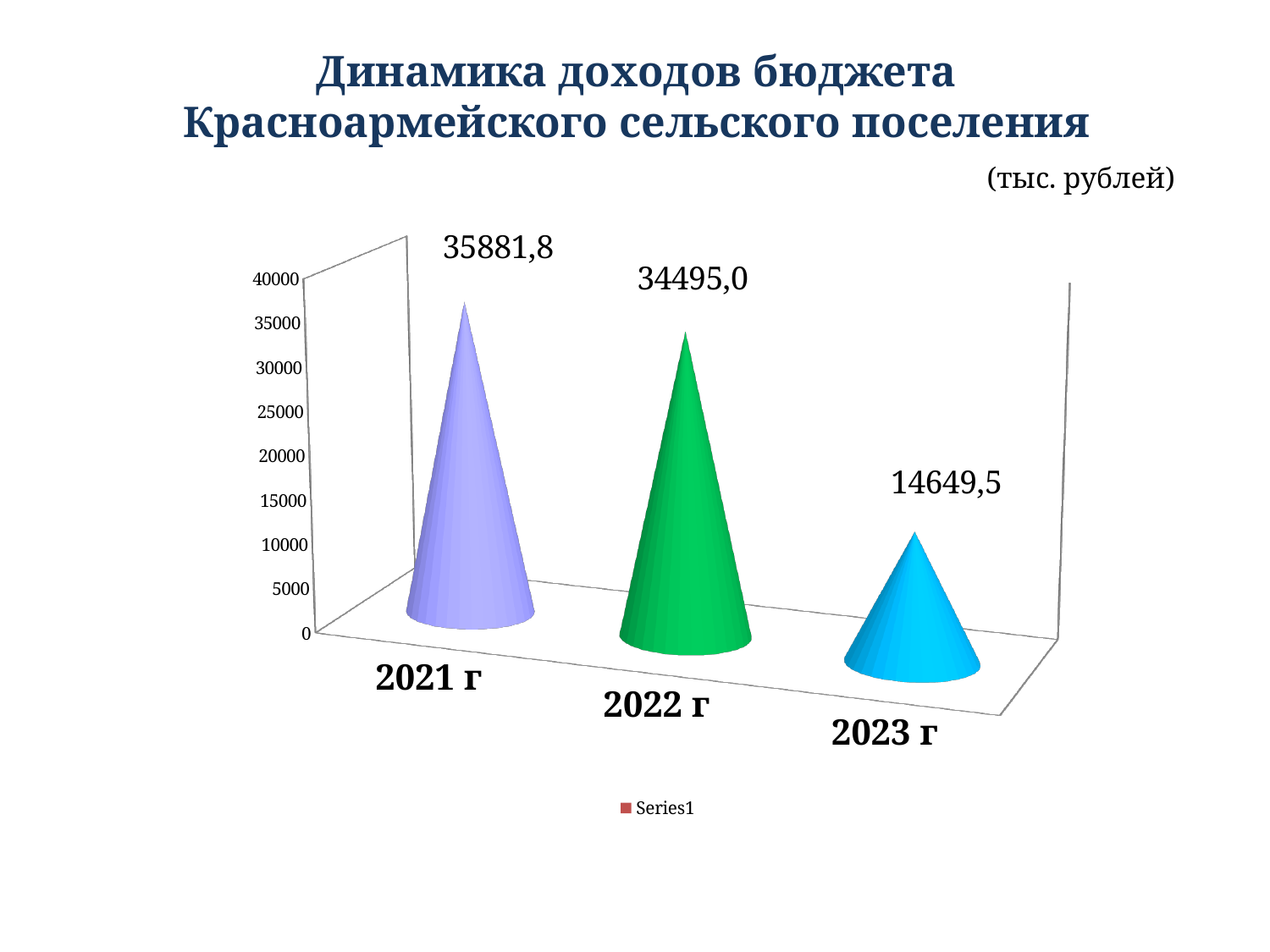
What is the budget income value shown for 2022 г? 34495,0 What unit is stated for the values on the chart? тыс. рублей Which is larger, the value for 2022 г or the value for 2023 г? 2022 г Which year has the lowest budget income value? 2023 г What is the budget income value shown for 2021 г? 35881,8 What is the difference between the values for 2022 г and 2023 г? 19845,5 Which year has the highest budget income value? 2021 г How many years are shown on the chart? 3 Is the value for 2023 г greater or less than 20000? less Do the values rise or fall from 2021 г to 2023 г? fall What is the budget income value shown for 2023 г? 14649,5 What is the difference between the values for 2021 г and 2023 г? 21232,3